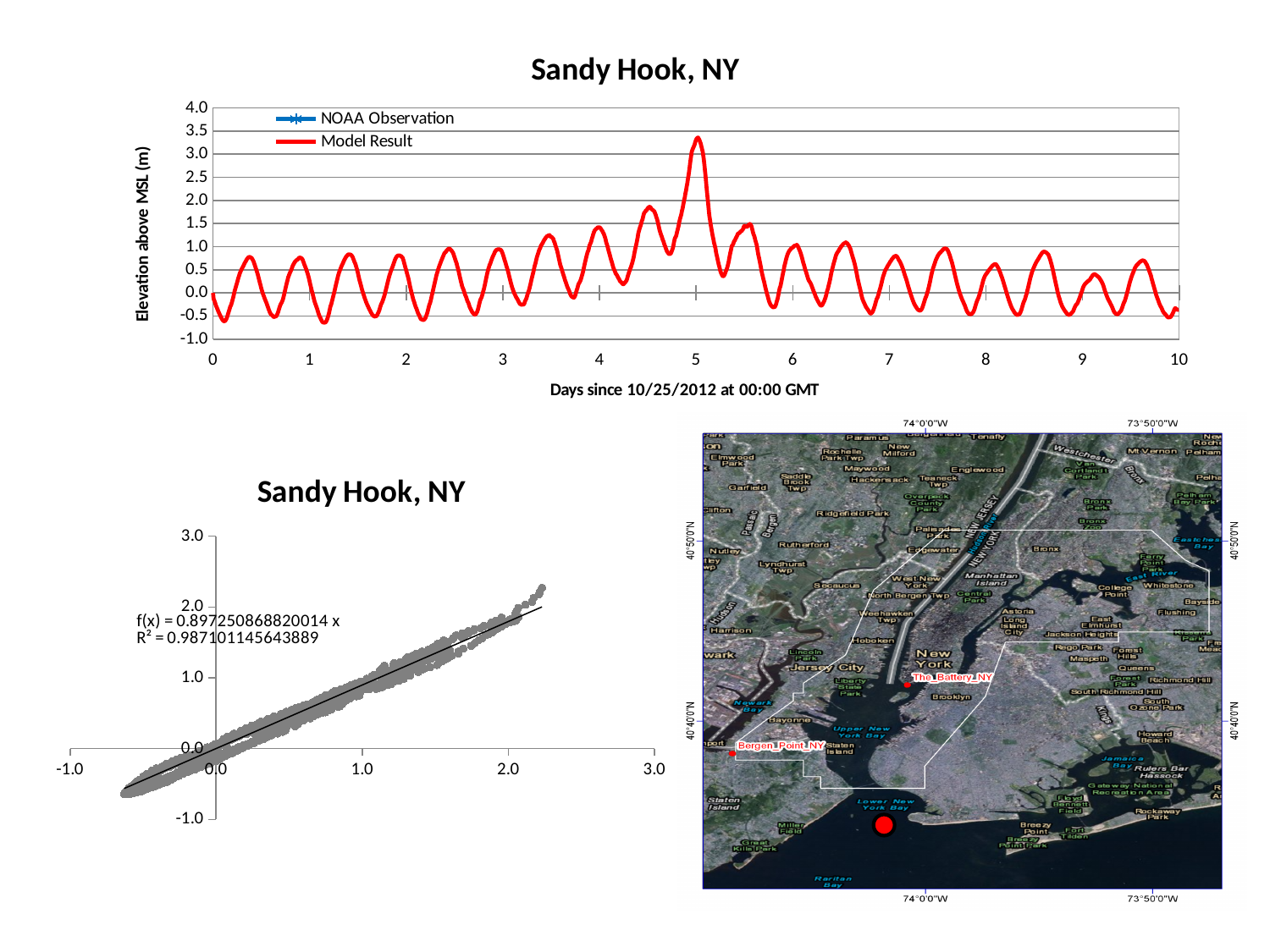
In the bottom-left scatter chart, what is the trendline equation shown? f(x) = 0.897250868820014 x In the bottom-left scatter chart, do the plotted points rise or fall as x increases? rise What are the two series named in the legend of the top line chart? NOAA Observation and Model Result In the top line chart, is the highest peak of the Model Result (near day 5) greater or less than 3.0? greater In the bottom-left scatter chart, what R² value is shown? 0.987101145643889 In the top line chart, what is the maximum value shown on the y-axis? 4.0 What kind of chart is the bottom-left chart titled "Sandy Hook, NY"? scatter chart How many series does the legend of the top line chart list? 2 In the top line chart, what is the y-axis title? Elevation above MSL (m) In the top line chart, is the lowest trough of the Model Result greater or less than 0.0? less What kind of chart is the top chart titled "Sandy Hook, NY"? line chart